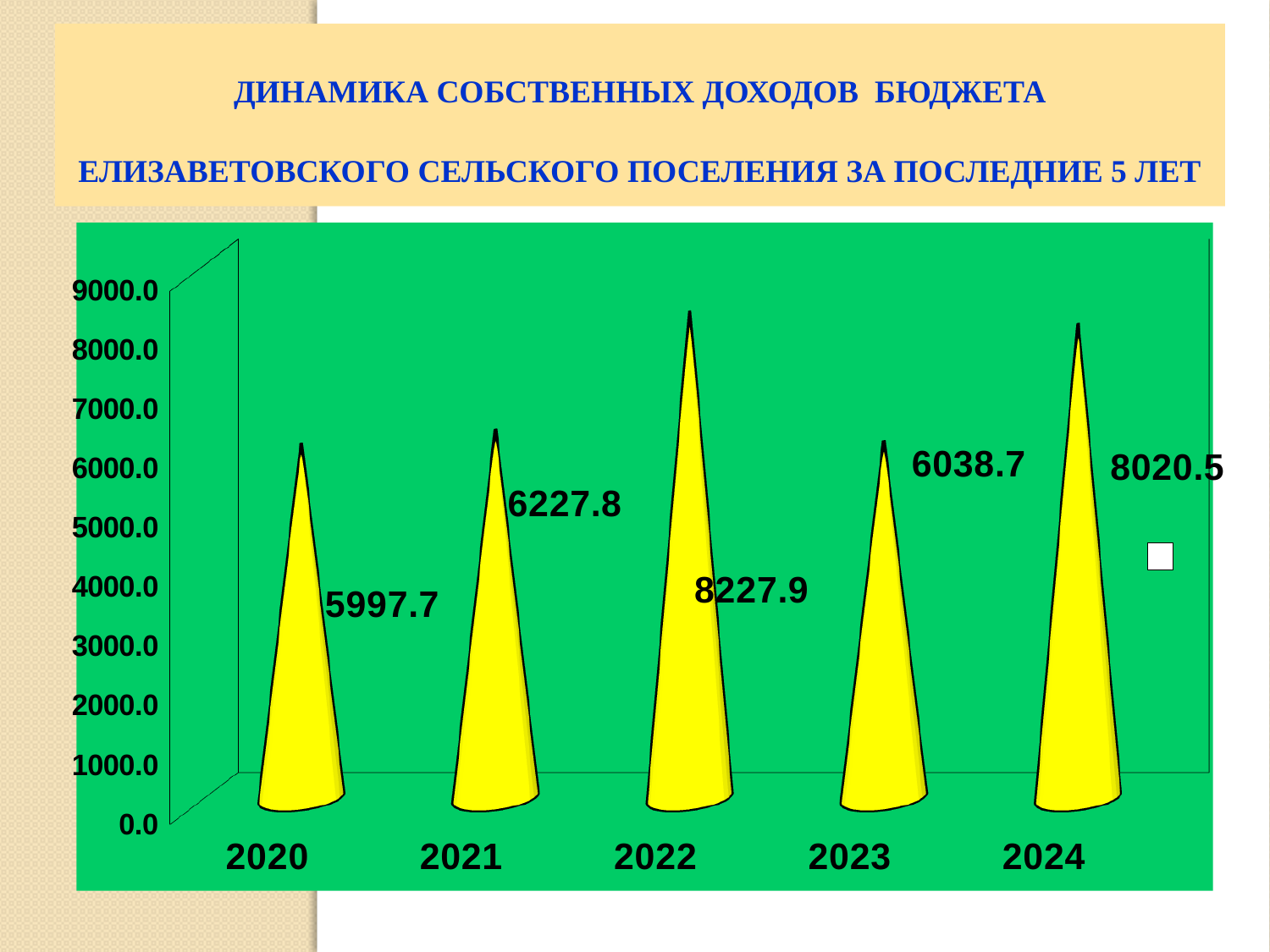
What kind of chart is shown on the slide? bar chart What is the value for 2024? 8020.5 What is the difference between the values for 2024 and 2023? 1981.8 Which year has the highest value? 2022 What is the value for 2022? 8227.9 What is the difference between the values for 2022 and 2021? 2000.1 Does the value rise or fall from 2022 to 2023? fall How many years are shown on the x axis? 5 Which year has the lowest value? 2020 What is the value for 2023? 6038.7 What is the value for 2020? 5997.7 Which is larger, the value for 2023 or the value for 2020? 2023